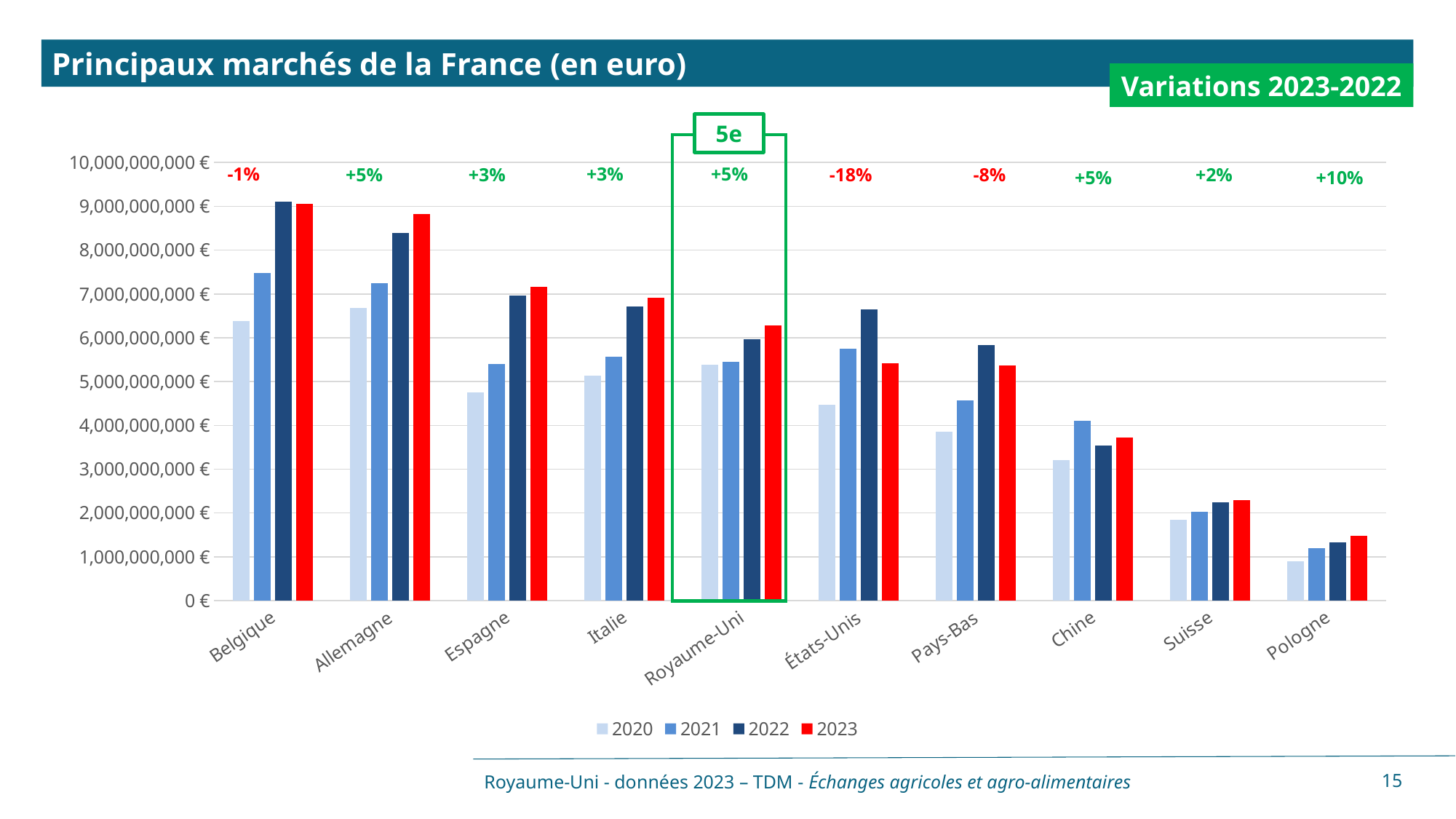
Which country has the lowest 2023 value? Pologne Is the 2023 value for Allemagne greater or less than 9,000,000,000 €? less Is the 2022 value for États-Unis greater or less than 6,000,000,000 €? greater What kind of chart is shown on the slide? bar chart How many series does the legend list? 4 Which country is marked with the '5e' box on the chart? Royaume-Uni What is the 2023-2022 variation printed above Belgique? -1% Which is larger for États-Unis: the 2022 value or the 2023 value? 2022 Which country has the highest 2023 value? Belgique What is the 2023-2022 variation printed above Pologne? +10% What is the 2023-2022 variation printed above États-Unis? -18% How many countries are shown on the x axis of the chart? 10